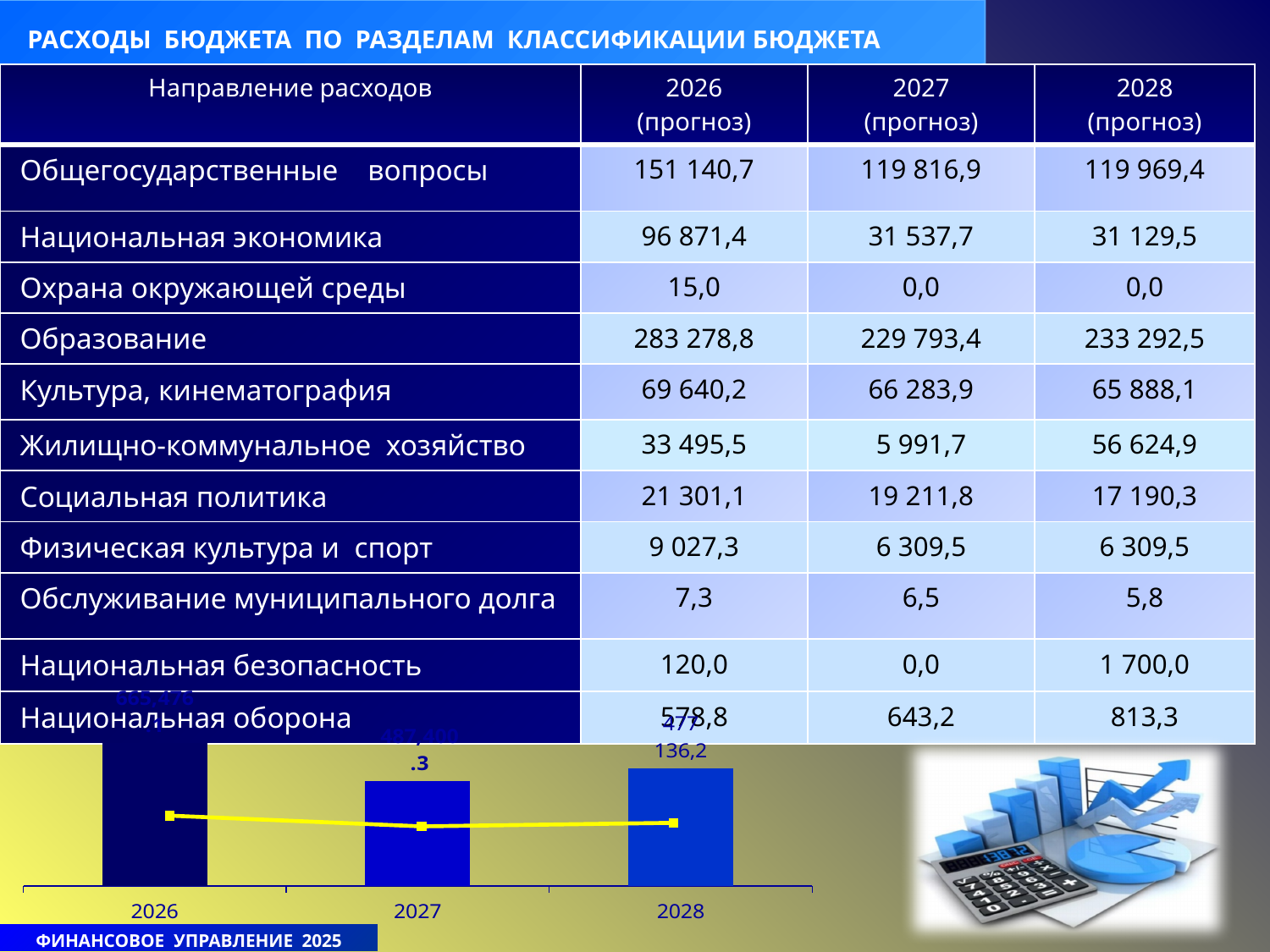
In the chart at the bottom of the slide, does the bar value rise or fall from 2026 to 2027? fall What are the category labels on the x axis of the chart at the bottom of the slide? 2026, 2027, 2028 In the chart at the bottom of the slide, which bar is taller, 2026 or 2028? 2026 In the chart at the bottom of the slide, which bar is taller, 2026 or 2027? 2026 What colour are the bars in the chart at the bottom of the slide? blue What kind of chart is shown at the bottom of the slide? bar chart How many categories are shown on the x axis of the chart at the bottom of the slide? 3 Which year has the tallest bar in the chart at the bottom of the slide? 2026